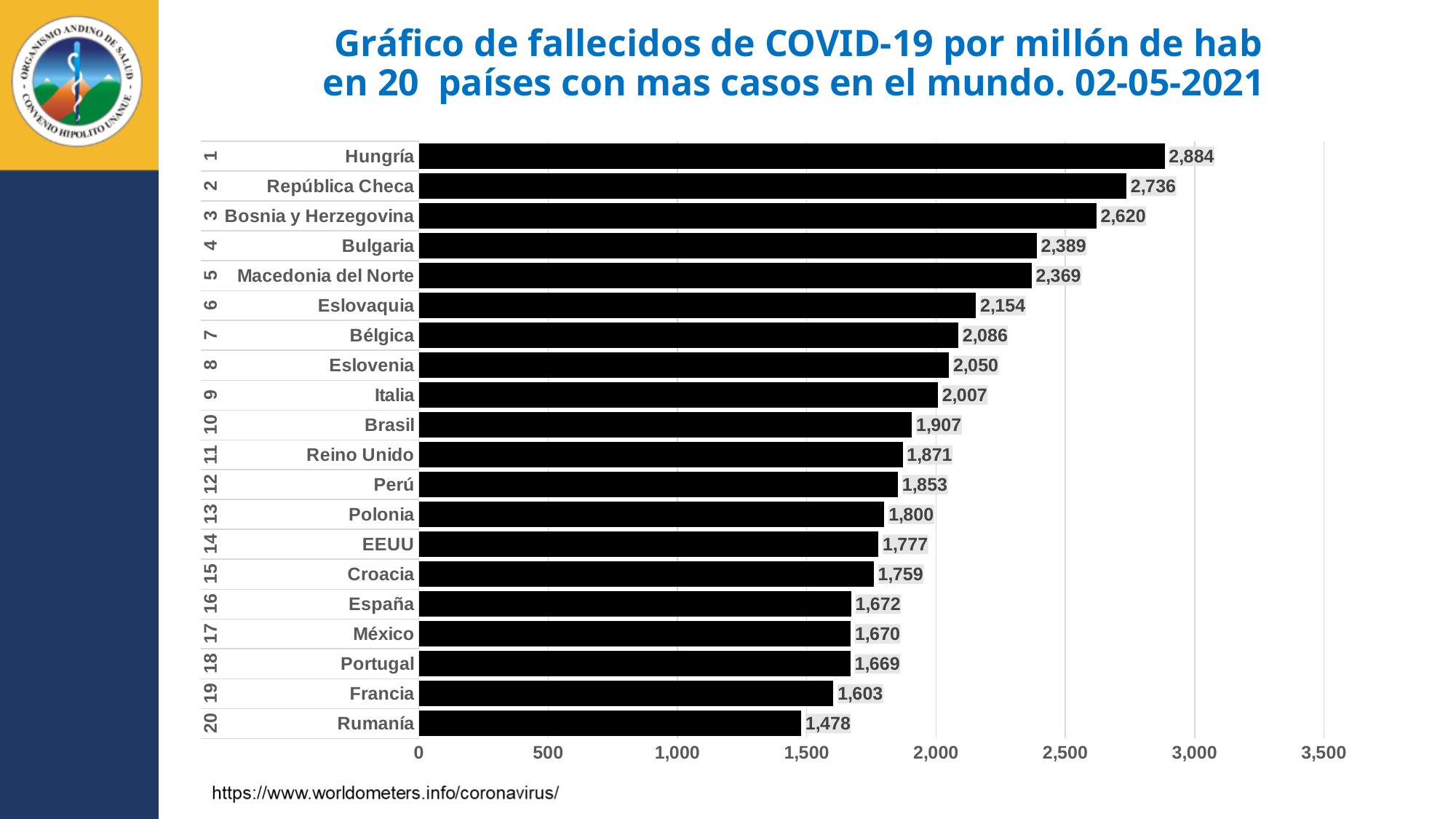
What source URL is shown below the chart? https://www.worldometers.info/coronavirus/ Which country has the lowest value? Rumanía What is the difference between the values for Brasil and Perú? 54 How many countries are shown in the chart? 20 What is the value for Perú? 1,853 What kind of chart is shown on the slide? bar chart Is the value for Italia greater or less than 1,500? greater Which country has the highest value? Hungría Which has a larger value, Bulgaria or Eslovaquia? Bulgaria What is the value for Hungría? 2,884 What is the value for Rumanía? 1,478 What is the difference between the values for Hungría and República Checa? 148